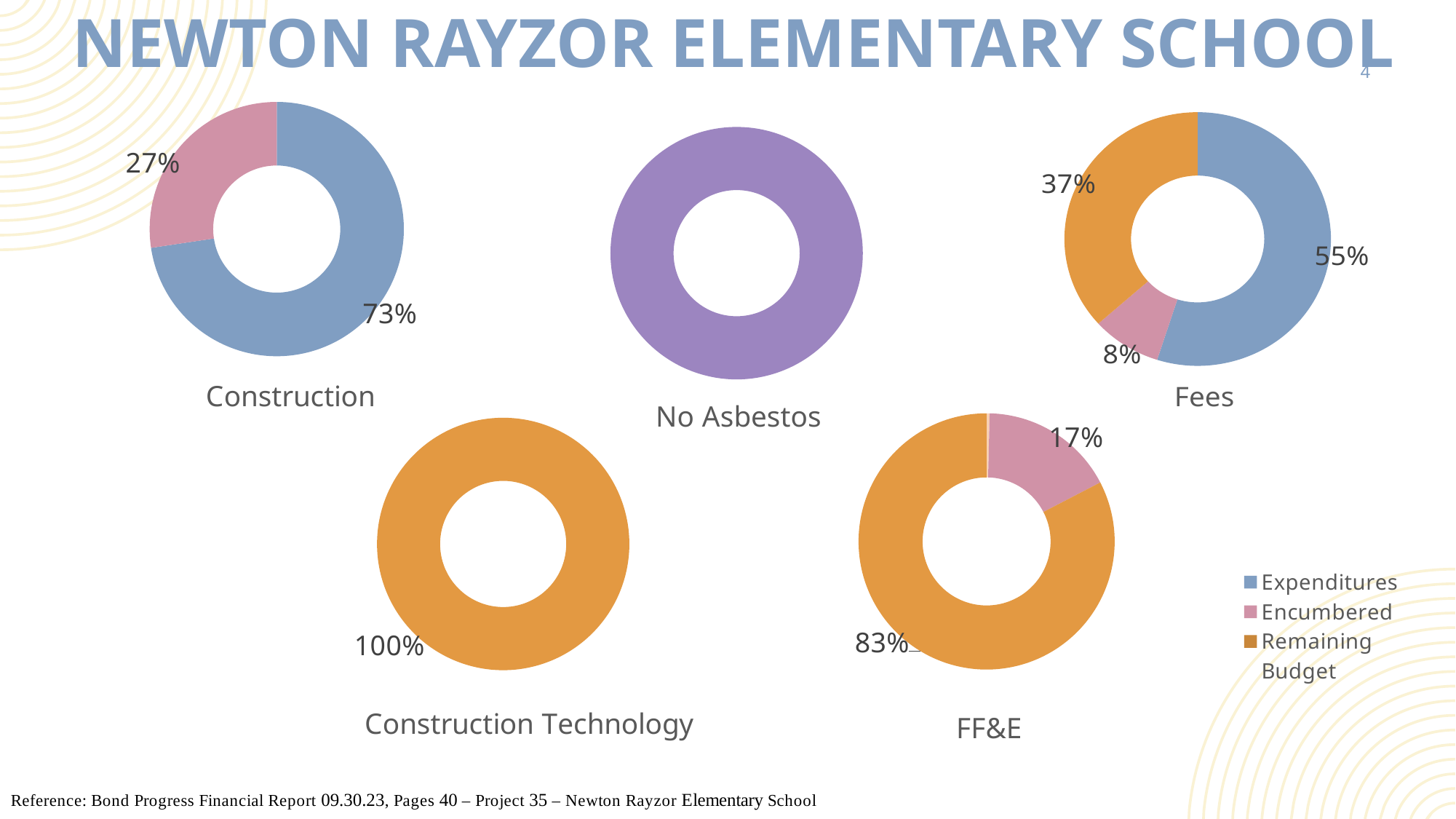
In the Fees chart, which category has the smallest share? Encumbered In the Construction Technology chart, what share is Remaining Budget? 100% In the Construction chart, what share is Encumbered? 27% In the Fees chart, which category has the largest share? Expenditures What kind of chart is the Construction chart? Donut (pie) chart In the FF&E chart, what share is Remaining Budget? 83% In the Fees chart, what share is Encumbered? 8% How many series does the legend list? 3 In the FF&E chart, what is the difference between the Remaining Budget share and the Encumbered share? 66 percentage points In the Fees chart, what share is Remaining Budget? 37% In the Fees chart, which is larger, Expenditures or Remaining Budget? Expenditures In the Construction chart, what share is Expenditures? 73%